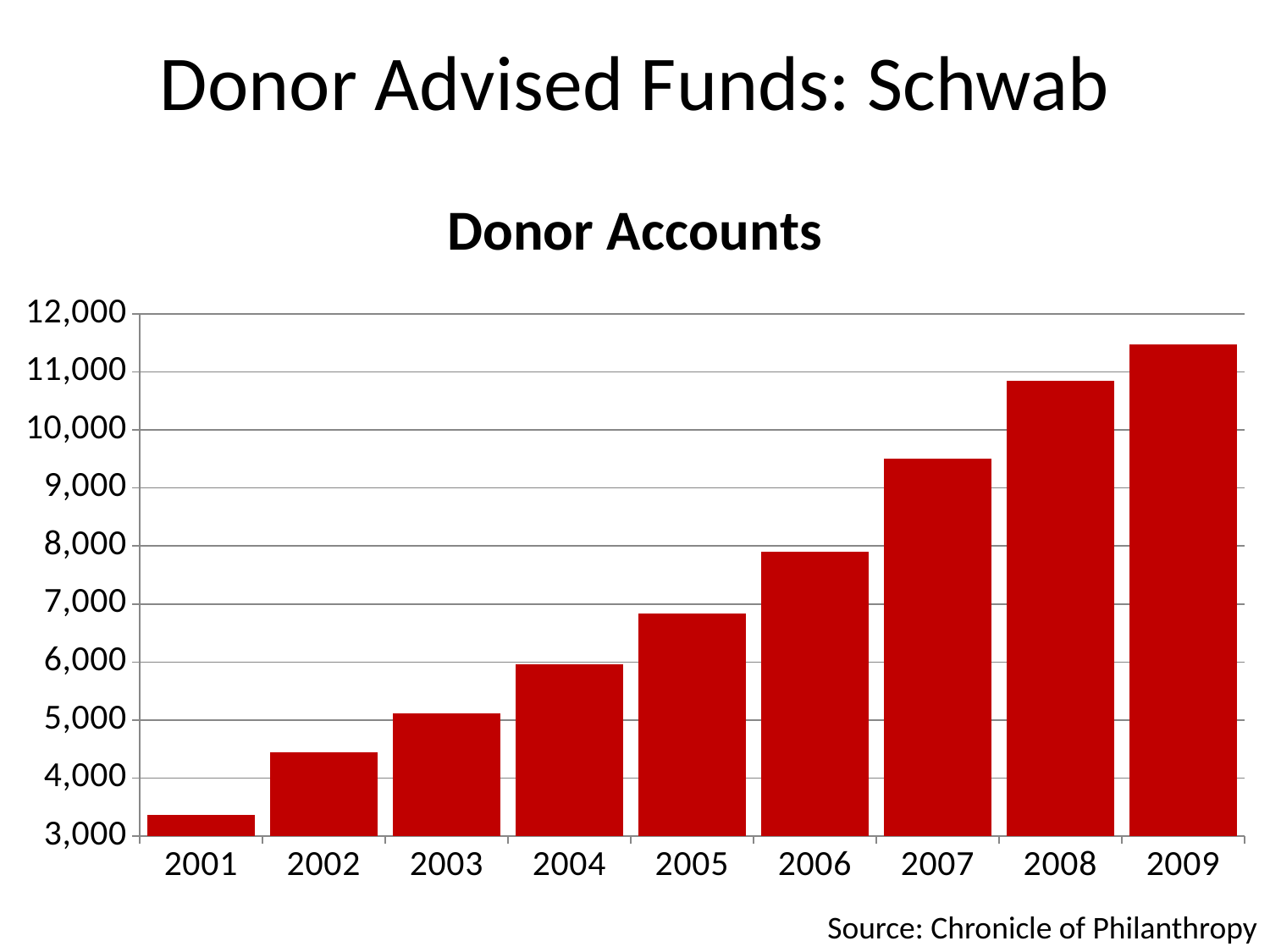
Which year has the lowest number of donor accounts? 2001 What type of chart is shown on the slide? bar chart Which year has more donor accounts, 2005 or 2006? 2006 What is the title of the chart? Donor Accounts Is the value for 2009 greater or less than 11,000? greater Is the value for 2002 greater or less than 5,000? less What source is cited for the chart data? Chronicle of Philanthropy Do the values rise or fall from 2001 to 2009? rise How many years are shown on the x axis of the chart? 9 Which year has the highest number of donor accounts? 2009 Is the value for 2007 greater or less than 9,000? greater